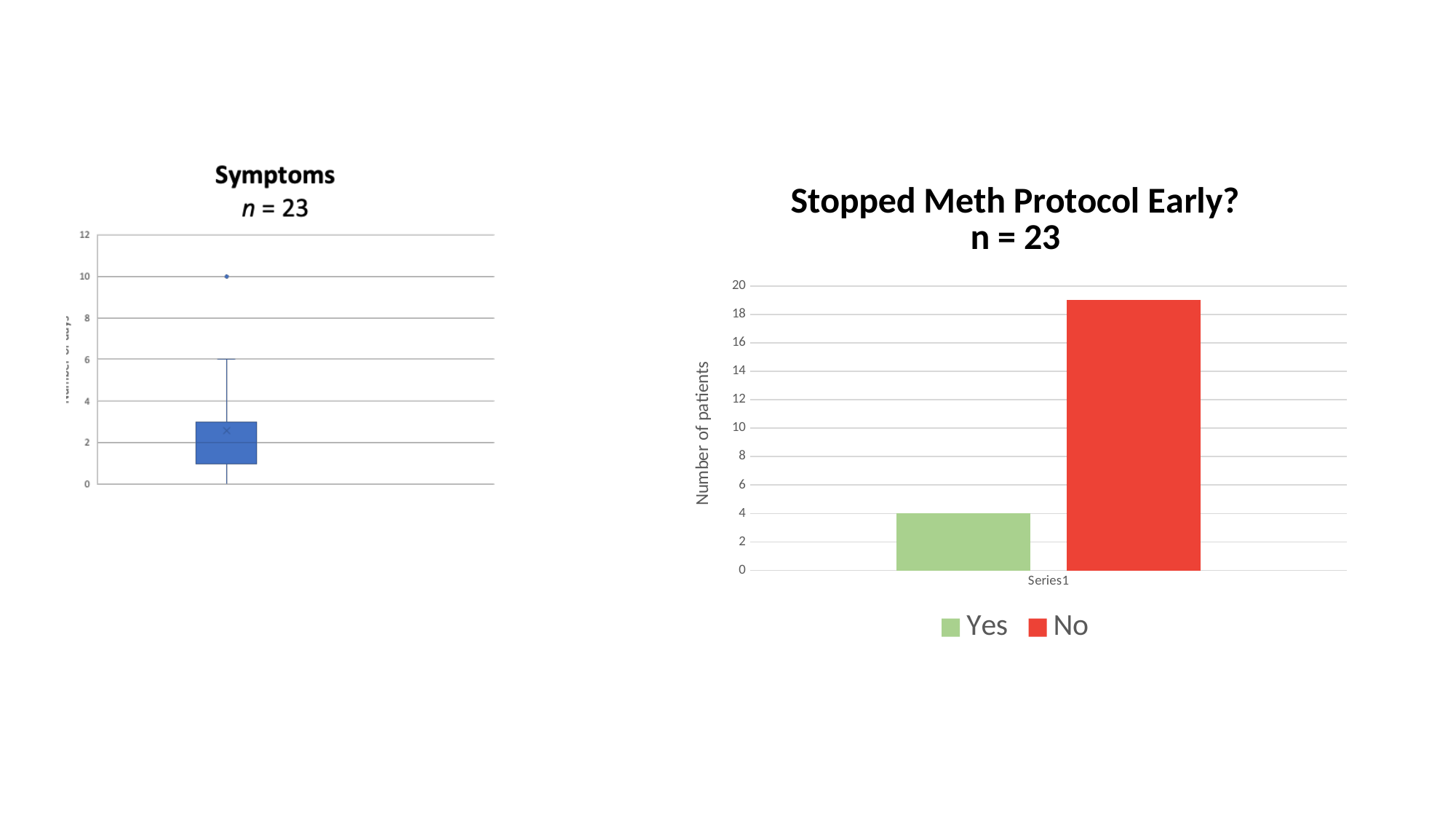
In the 'Stopped Meth Protocol Early?' chart, which series has the highest value? No In the 'Stopped Meth Protocol Early?' chart, is the value for 'No' greater or less than 18? greater In the 'Stopped Meth Protocol Early?' chart, what is the number of patients for 'Yes'? 4 In the 'Stopped Meth Protocol Early?' chart, which is larger, 'Yes' or 'No'? No In the 'Stopped Meth Protocol Early?' chart, which series has the lowest value? Yes What kind of chart is the chart on the right, titled 'Stopped Meth Protocol Early?'? bar chart What kind of chart is the chart on the left, titled 'Symptoms'? box plot In the 'Stopped Meth Protocol Early?' chart, how many series does the legend list? 2 In the 'Stopped Meth Protocol Early?' chart, what is the label on the vertical axis? Number of patients In the 'Stopped Meth Protocol Early?' chart, what colour is the 'No' bar? red In the 'Symptoms' box plot on the left, what is the value of the outlier point above the box? 10 In the 'Stopped Meth Protocol Early?' chart, is the value for 'Yes' greater or less than 10? less